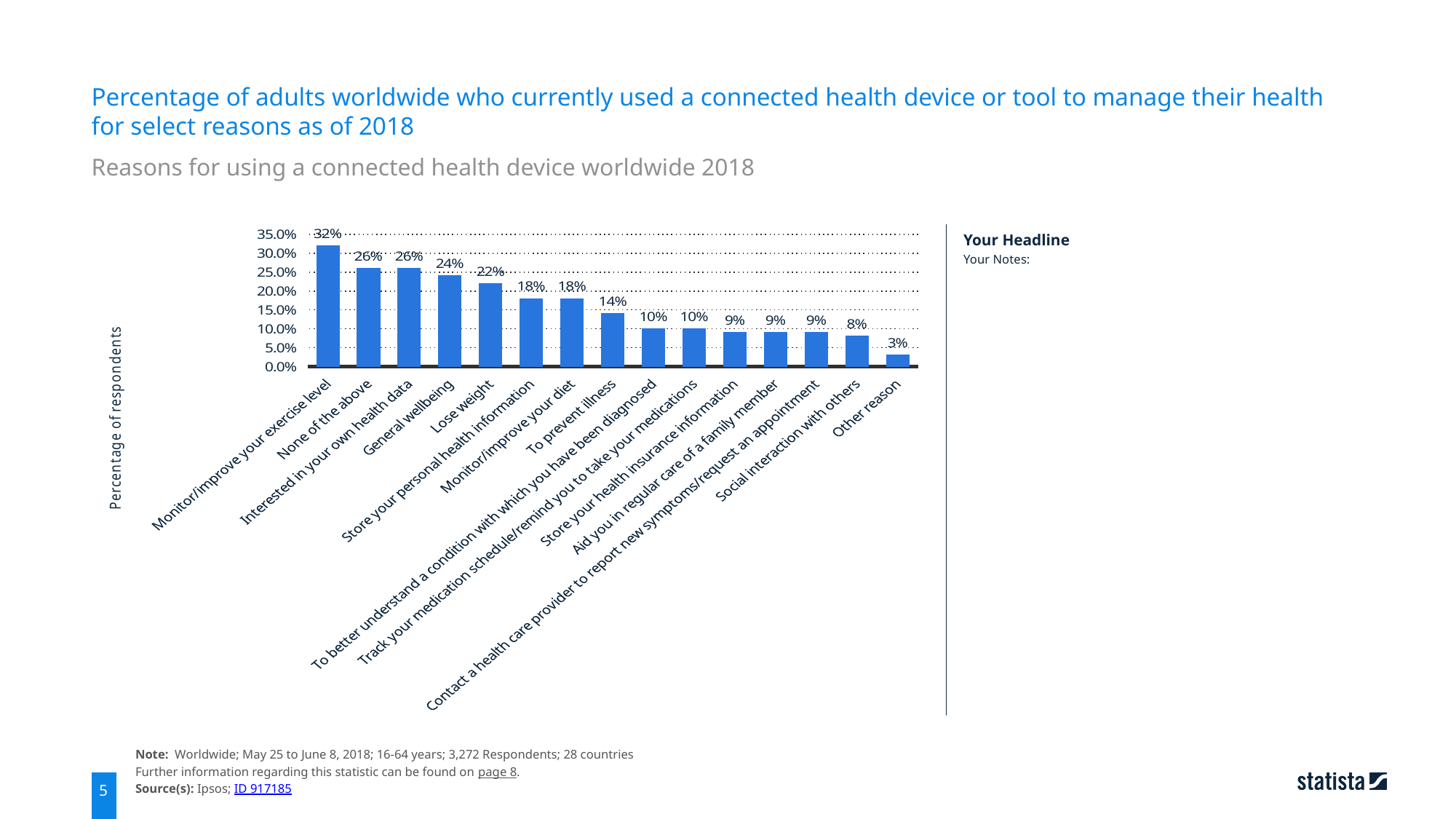
What percentage of respondents used a connected health device to monitor/improve their exercise level? 32% What is the value for 'To prevent illness'? 14% Which reason has the highest percentage of respondents? Monitor/improve your exercise level What is the value for 'Lose weight'? 22% Do the values generally rise or fall from left to right along the x axis? Fall Which category has the lowest value? Other reason What type of chart is shown on the slide? Bar chart What percentage of respondents selected 'Social interaction with others'? 8% What is the difference between 'Monitor/improve your exercise level' and 'General wellbeing'? 8% How many categories are shown in the chart? 15 What is the label of the vertical axis? Percentage of respondents Which is larger: 'Lose weight' or 'Monitor/improve your diet'? Lose weight